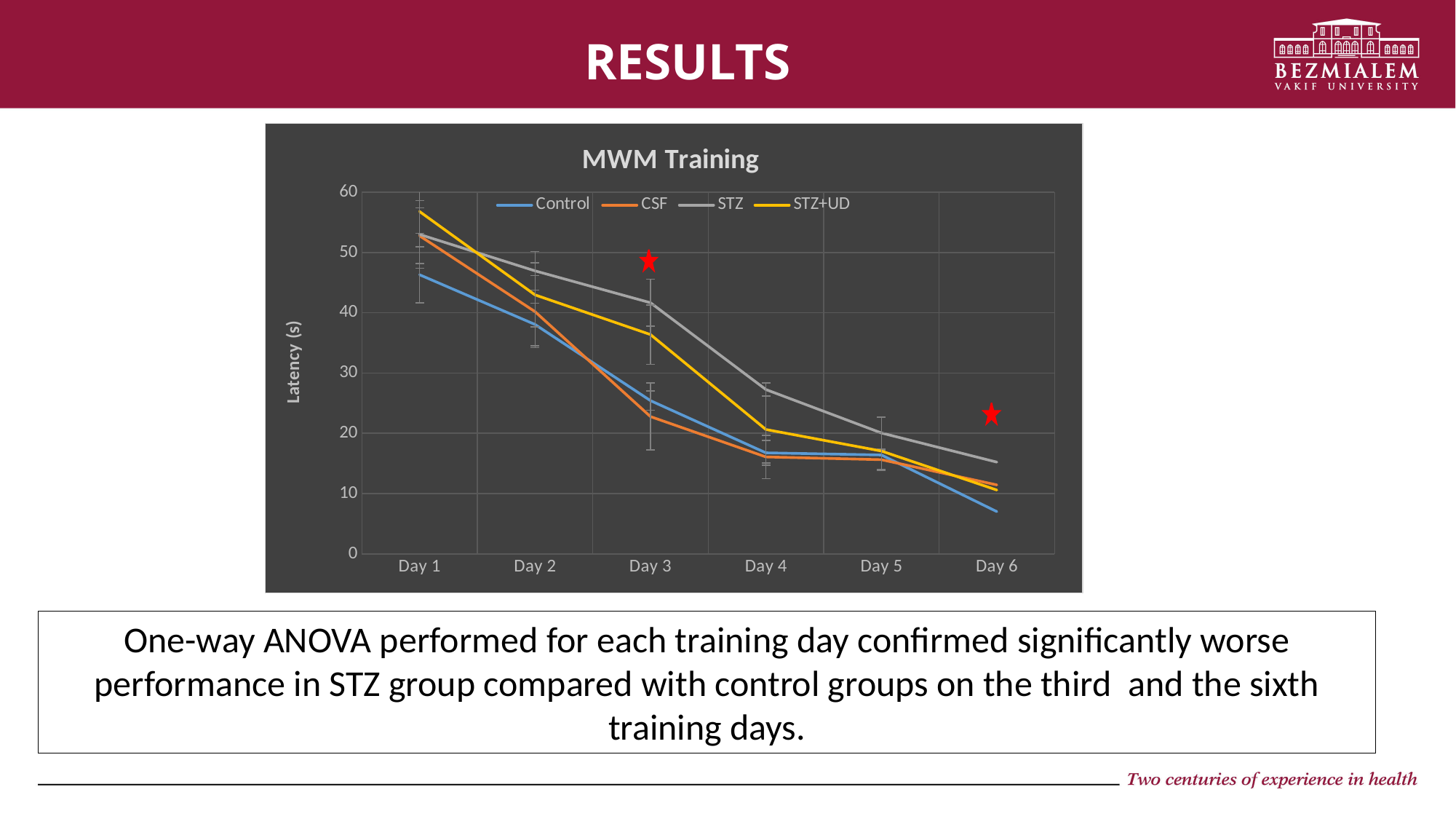
Does the latency for the STZ group rise or fall from Day 1 to Day 6? fall What is the label of the y axis? Latency (s) Is the latency for the STZ group on Day 3 greater or less than 30? greater How many series does the legend of the MWM Training chart list? 4 Which group has the highest latency on Day 6? STZ On Day 3, which group has the higher latency, STZ or Control? STZ What is the title of the chart? MWM Training Is the latency for the Control group on Day 6 greater or less than 10? less What kind of chart is shown on the slide? line chart Which group has the lowest latency on Day 6? Control Which group has the highest latency on Day 1? STZ+UD How many days are shown on the x axis of the MWM Training chart? 6